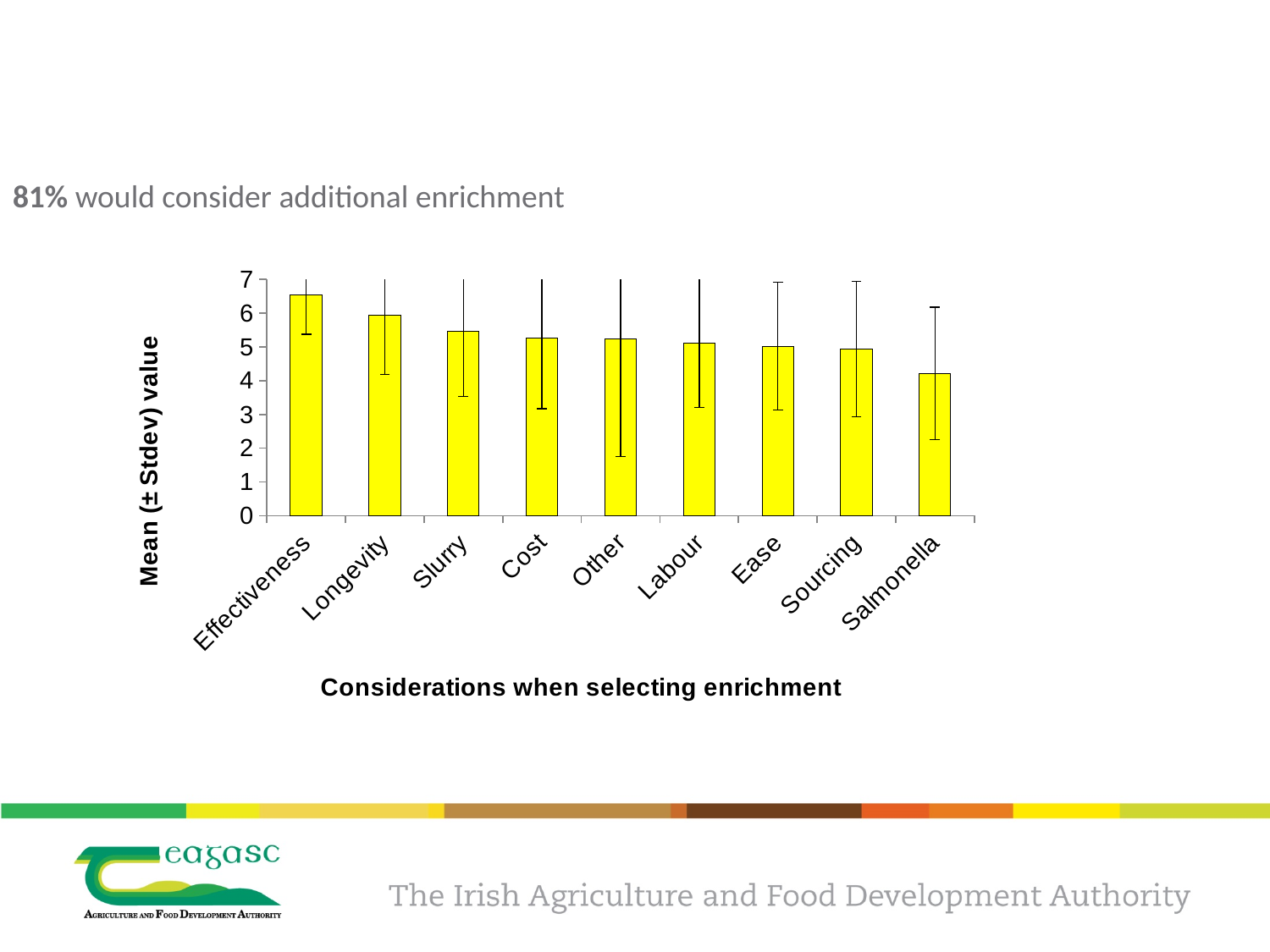
Which consideration has the highest mean value in the chart? Effectiveness What is the title of the x axis of the chart? Considerations when selecting enrichment Is the mean value for Labour greater or less than 4? greater What kind of chart is shown on the slide? bar chart Which has a larger mean value, Effectiveness or Salmonella? Effectiveness Is the mean value for Salmonella greater or less than 5? less Do the bar values rise or fall from left to right along the x axis? fall Which has a larger mean value, Longevity or Salmonella? Longevity Is the mean value for Slurry greater or less than 5? greater Which consideration has the lowest mean value in the chart? Salmonella How many categories are shown on the x axis of the chart? 9